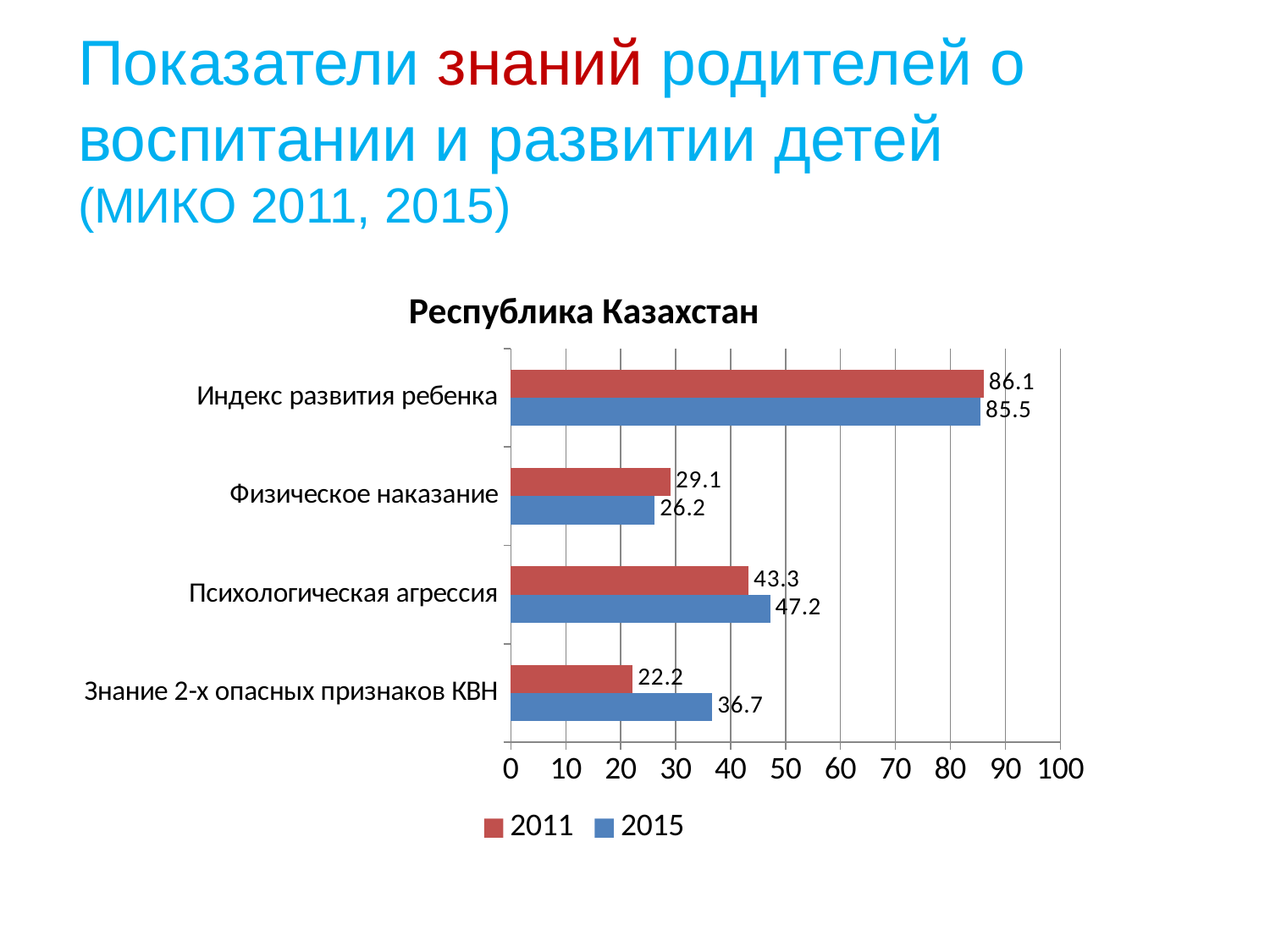
What is the 2015 value for Физическое наказание? 26.2 What is the 2011 value for Психологическая агрессия? 43.3 Which is larger for Психологическая агрессия: the 2011 value or the 2015 value? 2015 Which category has the lowest 2011 value? Знание 2-х опасных признаков КВН Which category has the highest 2011 value? Индекс развития ребенка How many categories are shown on the chart? 4 What kind of chart is shown on the slide? bar chart What is the title of the chart? Республика Казахстан Is the 2015 value for Индекс развития ребенка greater or less than 80? greater What is the difference between the 2015 and 2011 values for Знание 2-х опасных признаков КВН? 14.5 What is the 2015 value for Знание 2-х опасных признаков КВН? 36.7 How many series does the legend list? 2